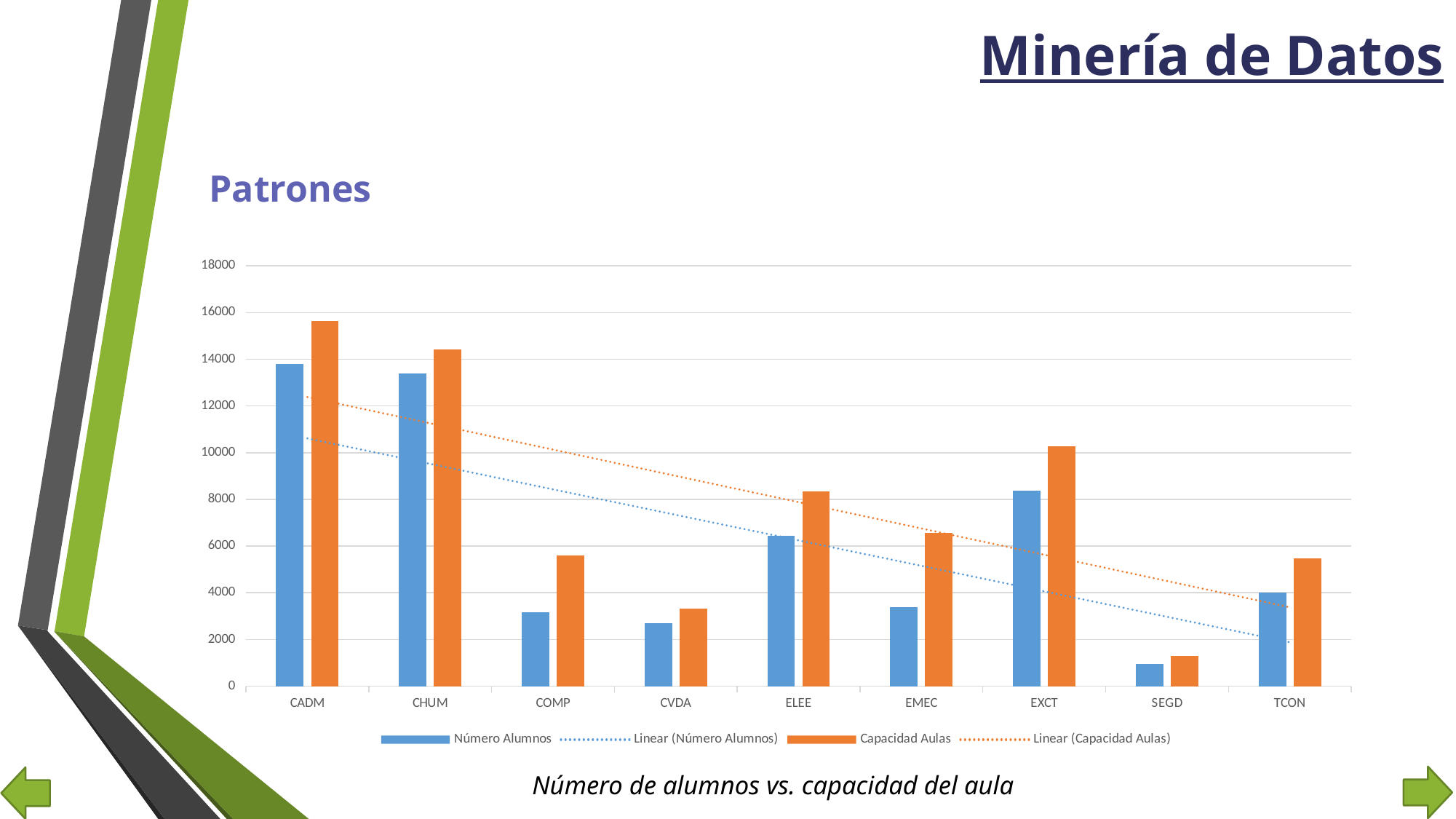
Do the dotted linear trend lines rise or fall from left to right across the x axis? fall Which category has the highest Capacidad Aulas value? CADM For EMEC, which is larger, Número Alumnos or Capacidad Aulas? Capacidad Aulas Which is larger, the Número Alumnos value for EXCT or for ELEE? EXCT Is the Capacidad Aulas value for SEGD greater or less than 2000? less Which category has the lowest Número Alumnos value? SEGD What kind of chart is shown on the slide? bar chart Is the Capacidad Aulas value for CADM greater or less than 14000? greater Which category has the lowest Capacidad Aulas value? SEGD How many categories are shown on the x axis of the chart? 9 How many entries does the chart's legend list? 4 Is the Número Alumnos value for EXCT greater or less than 8000? greater